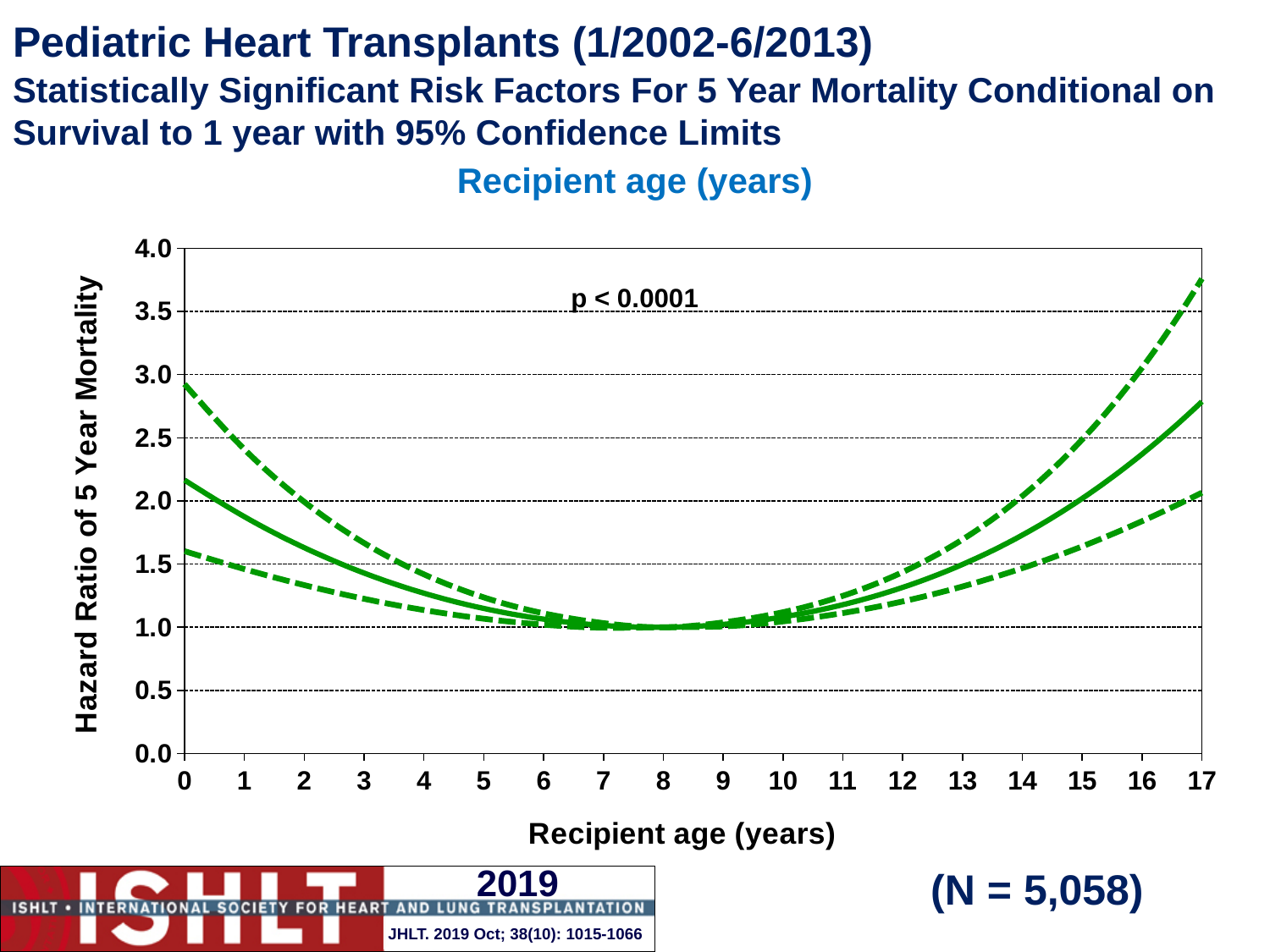
Which has the larger hazard ratio on the solid line: recipient age 0 or recipient age 17? recipient age 17 What kind of chart is shown on the slide? line chart Is the hazard ratio shown by the solid line at recipient age 0 greater or less than 2.0? greater Does the solid hazard ratio line rise or fall as recipient age increases from 0 to 8 years? fall Is the hazard ratio shown by the solid line at recipient age 17 greater or less than 2.5? greater Is the upper confidence limit (upper dashed line) at recipient age 0 greater or less than 2.5? greater What p-value is printed on the chart? p < 0.0001 Does the solid hazard ratio line rise or fall as recipient age increases from 8 to 17 years? rise What sample size (N) is shown on the slide? N = 5,058 How many lines are plotted on the chart? 3